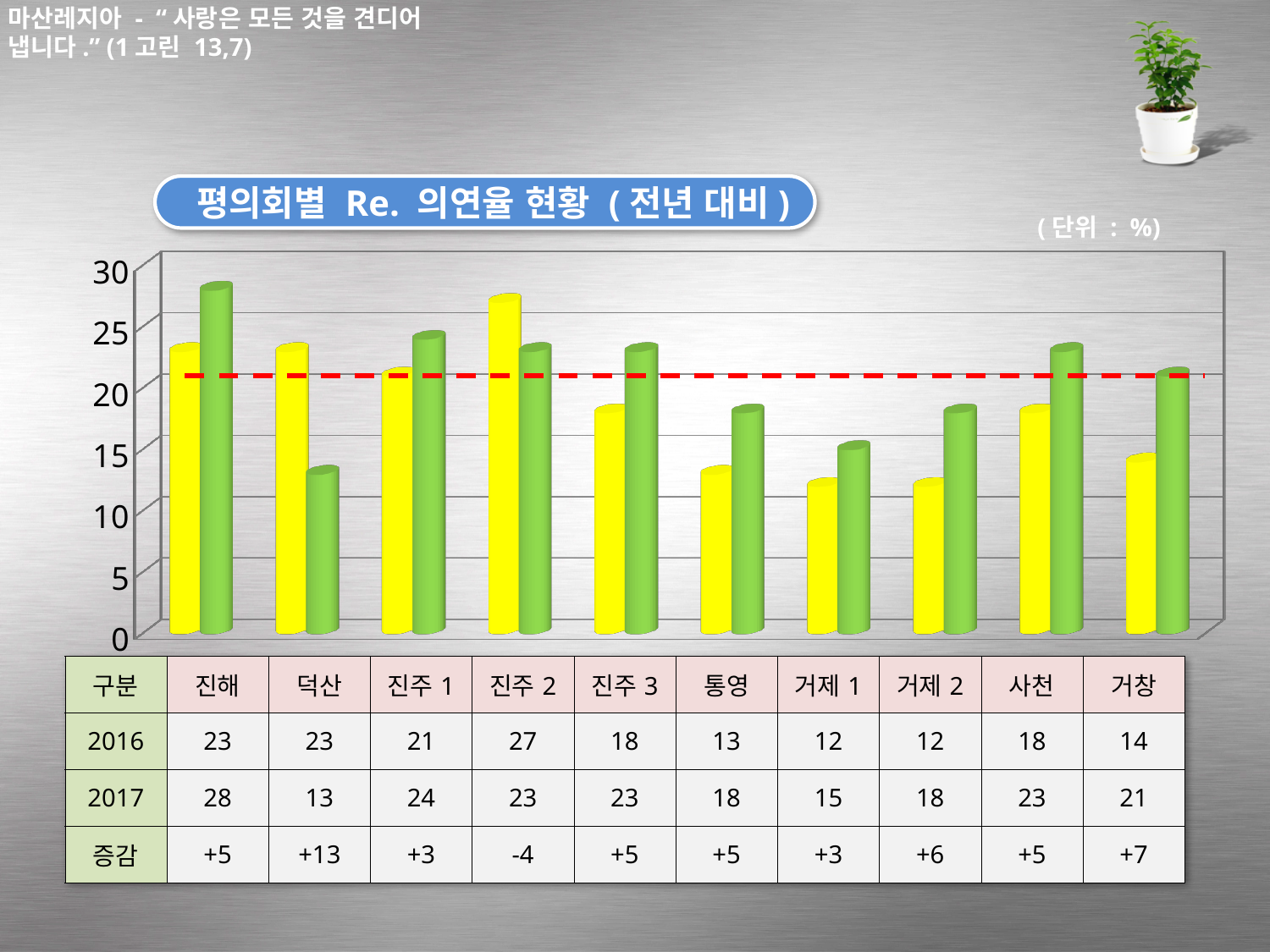
Which category has the lowest 2017 value? 덕산 What unit is indicated for the chart values? % What type of chart is shown on the slide? bar chart Which category has the highest 2016 value? 진주 2 What is the 2016 value for 진주 2? 27 Is the 2017 value for 사천 greater or less than 20? greater Which category has the highest 2017 value? 진해 Which is larger for 진주 2: the 2016 value or the 2017 value? 2016 How many categories (평의회) are shown along the x axis of the chart? 10 What is the 2017 value for 거제 1? 15 What is the difference between the 2017 and 2016 values for 거창? 7 What is the 2017 value for 진해? 28